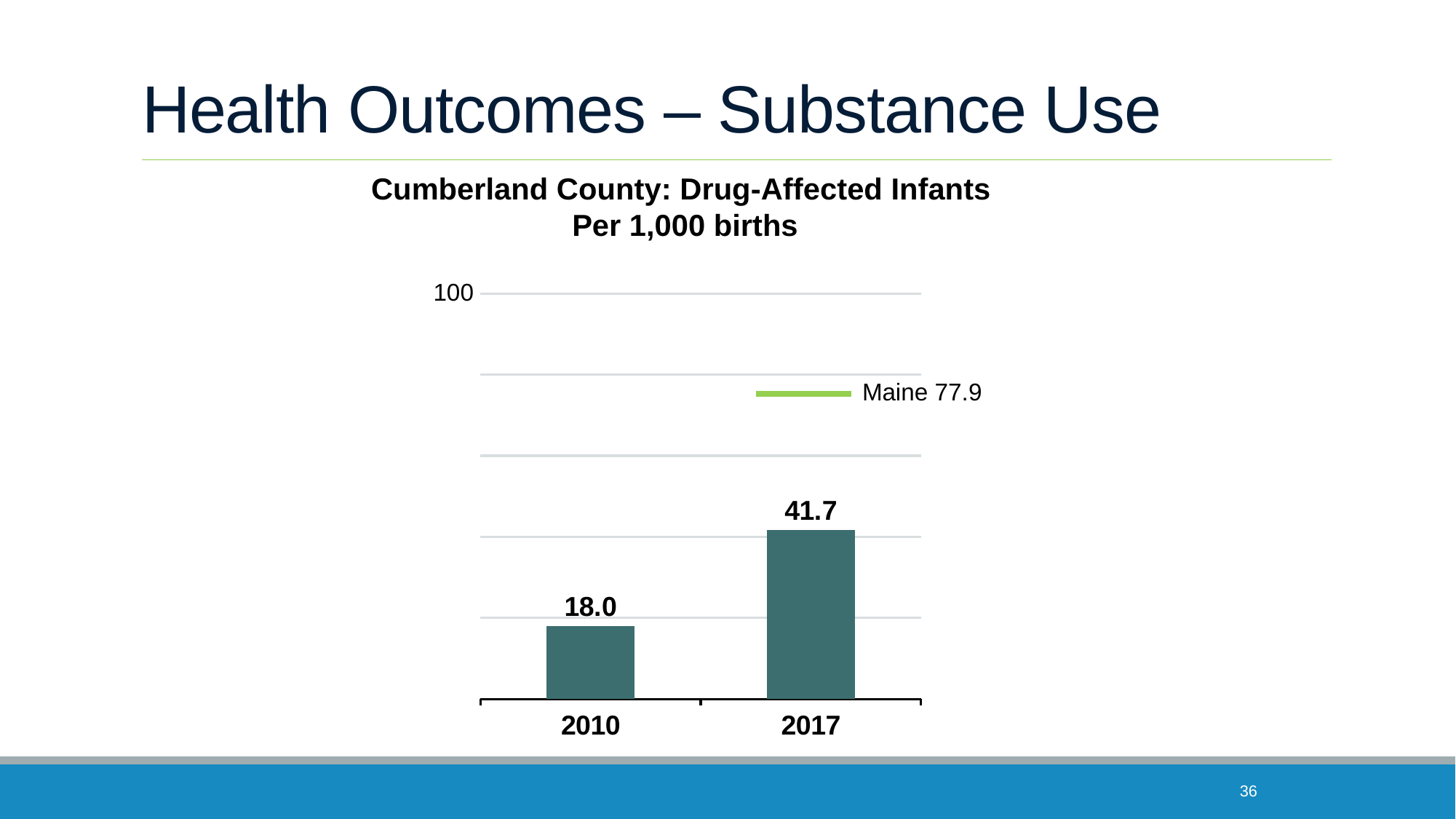
What is the value for 2017? 41.7 Which year has the lower value? 2010 What is the title of the chart? Cumberland County: Drug-Affected Infants Per 1,000 births What kind of chart is this? Bar chart What is the value for 2010? 18.0 Is the value for 2017 greater or less than 100? less What is the difference between the 2017 and 2010 values? 23.7 Which year has the higher value? 2017 How many years are shown on the x axis? 2 Is the value for 2017 larger than the value for 2010? Yes What is the Maine value shown on the chart? 77.9 Do the values rise or fall from 2010 to 2017? Rise